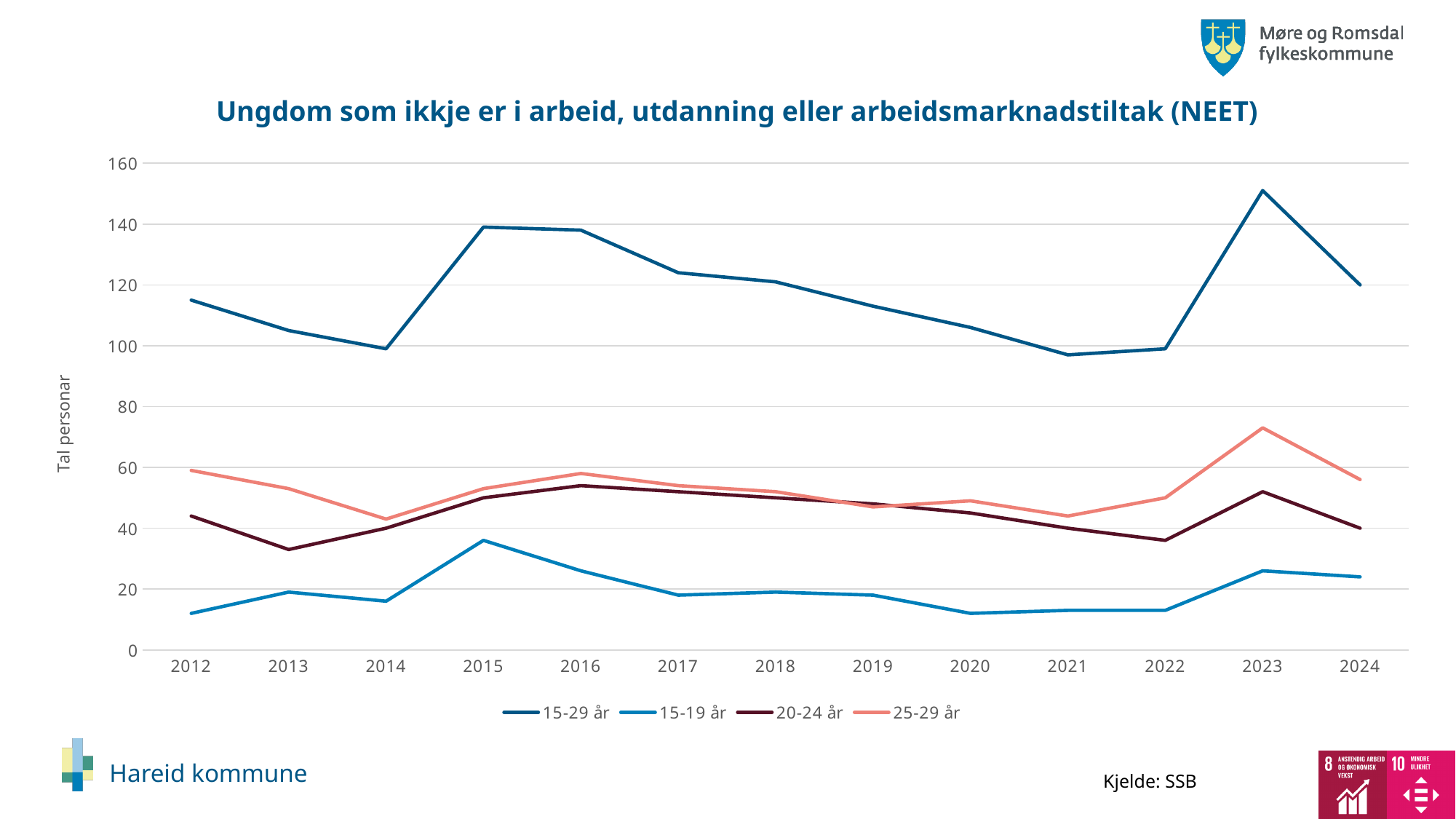
Is the value for 25-29 år in 2023 greater or less than 60? greater What is the label on the y axis? Tal personar How many series does the legend list? 4 Is the value for 15-29 år in 2023 greater or less than 140? greater How many years are shown on the x axis? 13 In which year does the 25-29 år series reach its highest value? 2023 In which year does the 15-29 år series reach its highest value? 2023 What kind of chart is shown on the slide? line chart In which year does the 15-19 år series reach its highest value? 2015 Does the 15-29 år series rise or fall between 2016 and 2021? fall Which is larger for the 15-29 år series: the value in 2023 or the value in 2024? 2023 Is the value for 15-29 år in 2021 greater or less than 100? less